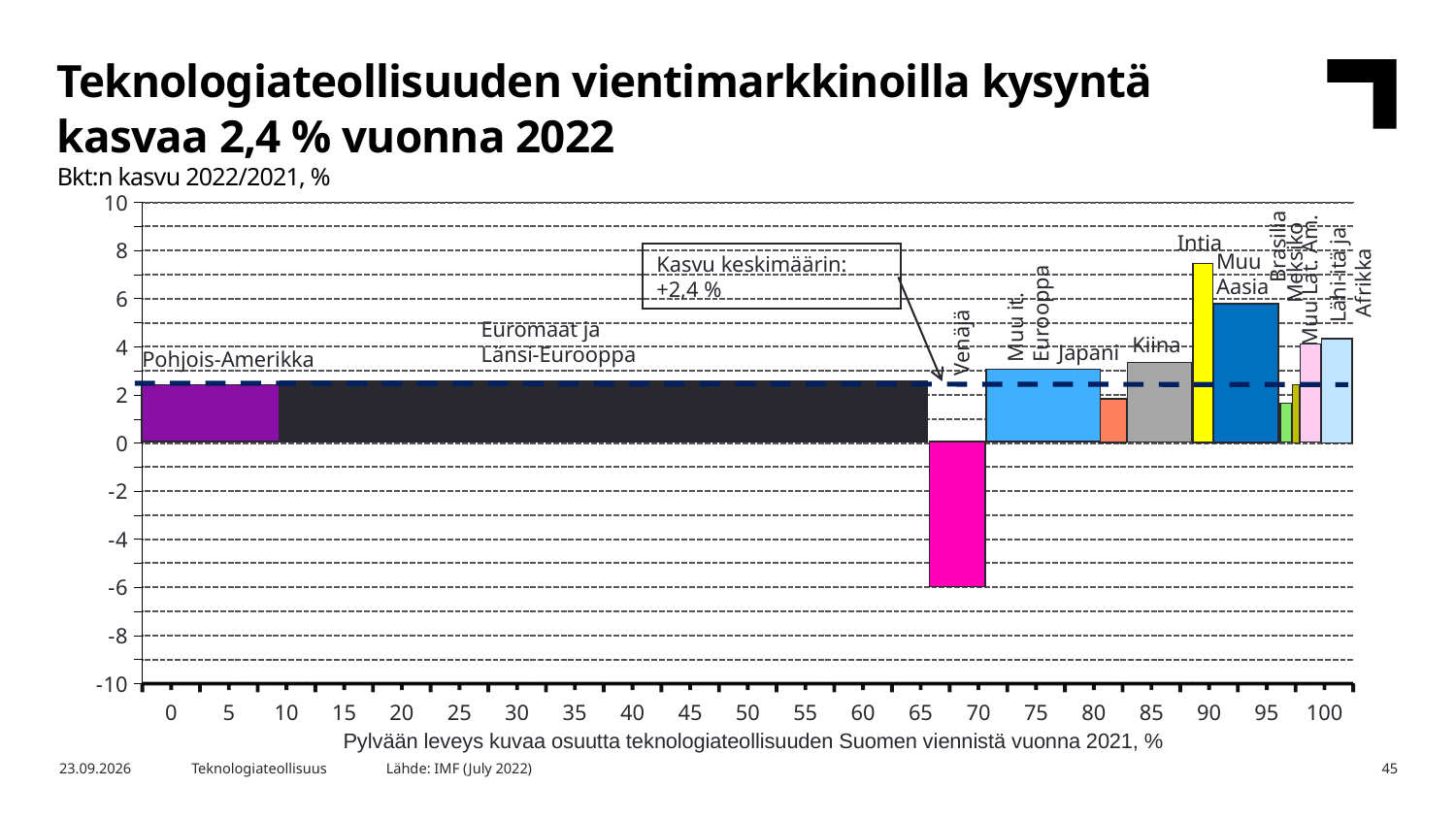
What kind of chart is shown on the slide? bar chart According to the note below the x axis, what does the width of each bar represent? The region's share of Finland's technology industry exports in 2021, % Is the value for Japani greater or less than 4? less Which has the larger value, Intia or Kiina? Intia Is the value for Intia greater or less than 6? greater What is the average growth (Kasvu keskimäärin) shown in the chart annotation? +2,4 % Is the value for Muu Aasia greater or less than 4? greater Which region has the highest GDP growth in the chart? Intia Which has the larger value, Venäjä or Japani? Japani Which region has the lowest GDP growth in the chart? Venäjä